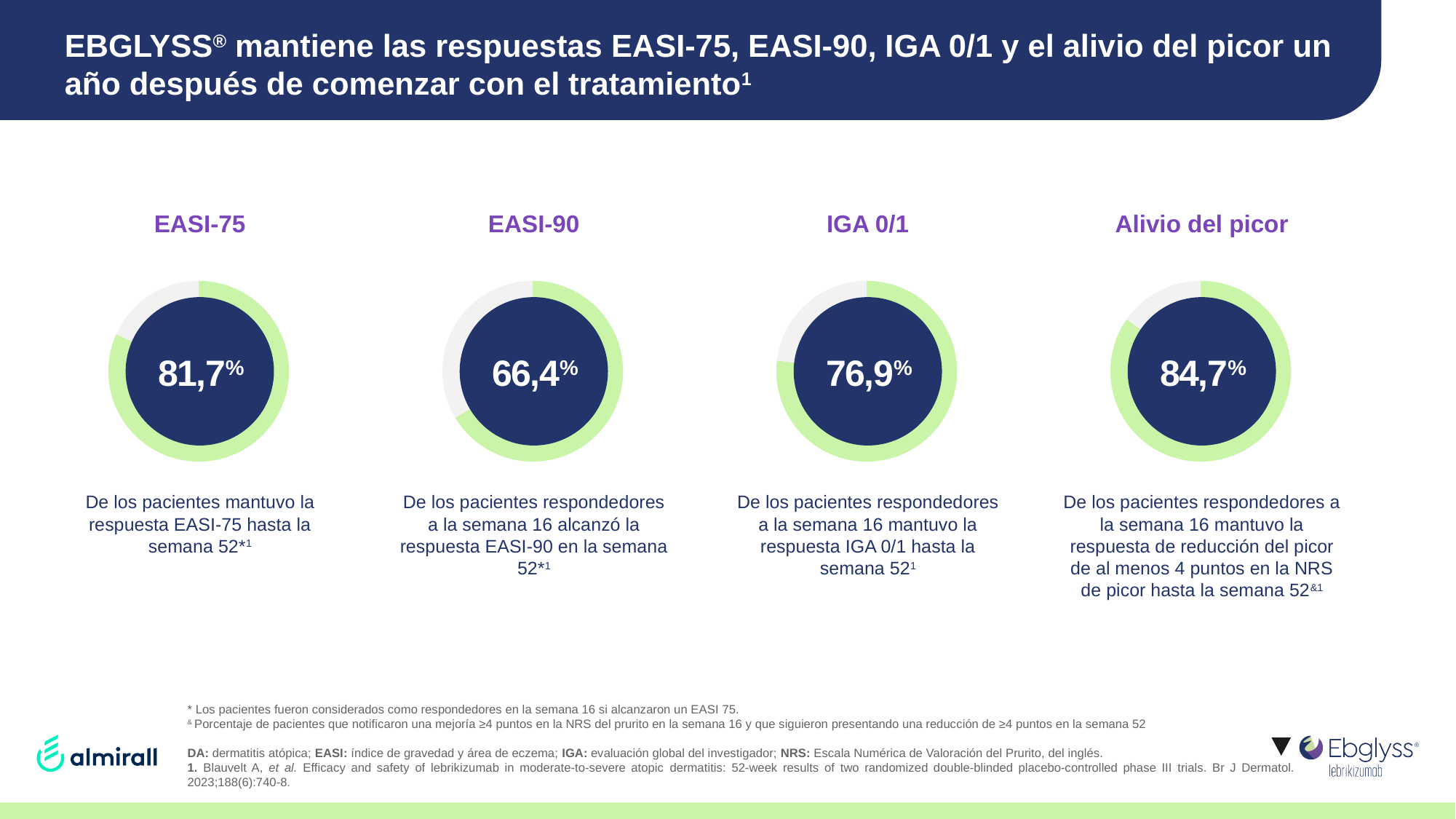
What colour is the filled portion of the ring in the Alivio del picor chart? Green What value is shown in the IGA 0/1 chart? 76,9% What kind of chart is used to show the EASI-75 value? Donut (ring) chart What value is shown in the EASI-75 chart? 81,7% What value is shown in the EASI-90 chart? 66,4% How many ring charts are shown on the slide? 4 Which is larger, the value in the IGA 0/1 chart or the value in the EASI-90 chart? IGA 0/1 What value is shown in the Alivio del picor chart? 84,7% What is the difference between the value in the EASI-75 chart and the value in the EASI-90 chart? 15,3% Across the four charts on the slide, which one shows the highest percentage? Alivio del picor Across the four charts on the slide, which one shows the lowest percentage? EASI-90 What is the difference between the value in the Alivio del picor chart and the value in the IGA 0/1 chart? 7,8%